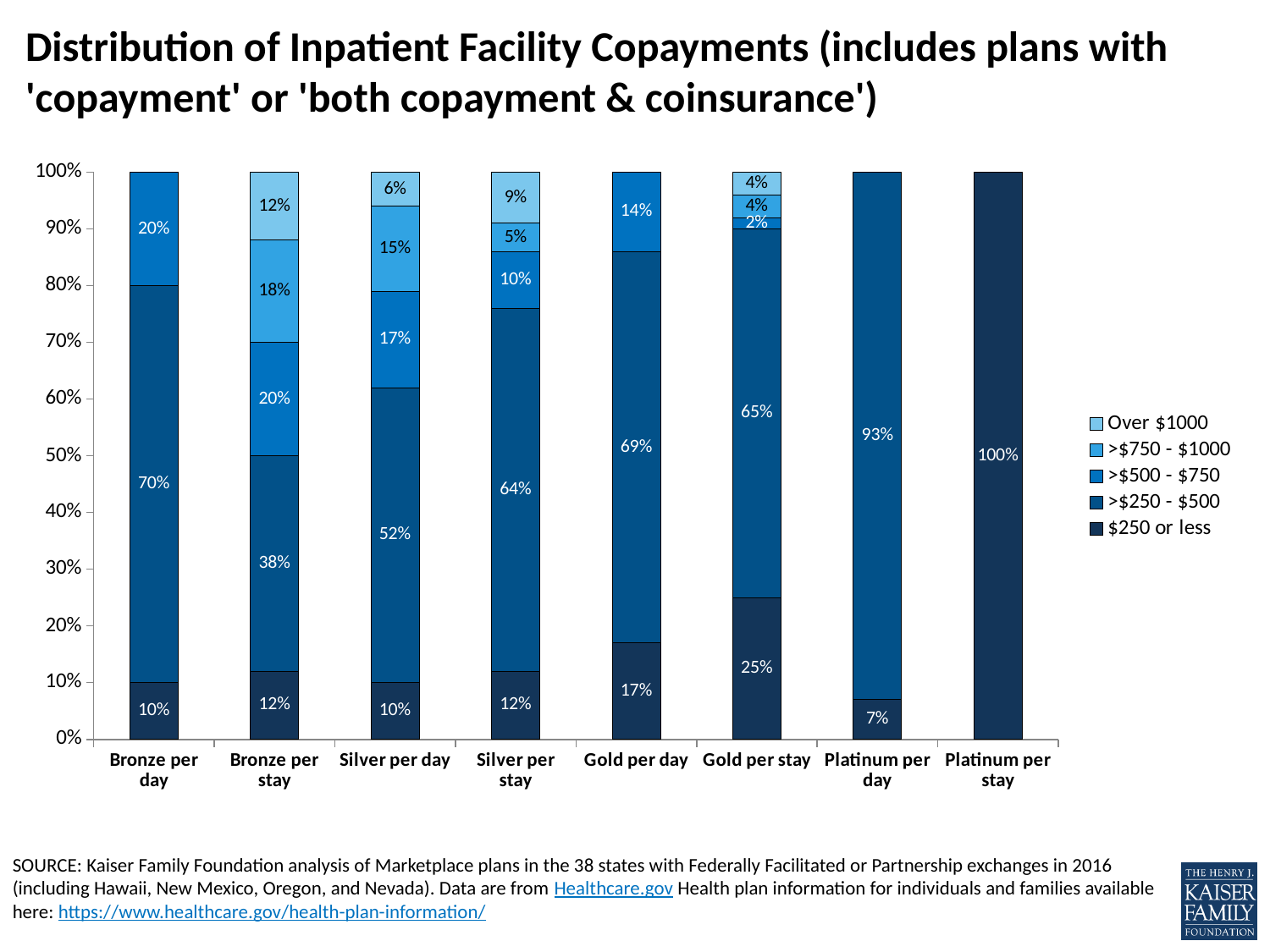
Which category has the largest '$250 or less' segment? Platinum per stay How many series does the legend list? 5 What is the value of the '$250 or less' segment for Gold per stay? 25% What is the difference between the '>$250 - $500' segment for Platinum per day and for Gold per day? 24% What is the value of the '>$500 - $750' segment for Gold per day? 14% Which category has the smallest '$250 or less' segment? Platinum per day What is the value of the '>$250 - $500' segment for Bronze per day? 70% Which is larger: the '>$500 - $750' segment for Silver per day or for Silver per stay? Silver per day What is the value of the 'Over $1000' segment for Bronze per stay? 12% What kind of chart is shown on the slide? Stacked bar chart What is the total of the '$250 or less' and '>$250 - $500' segments for Silver per stay? 76% How many categories are shown along the x axis? 8